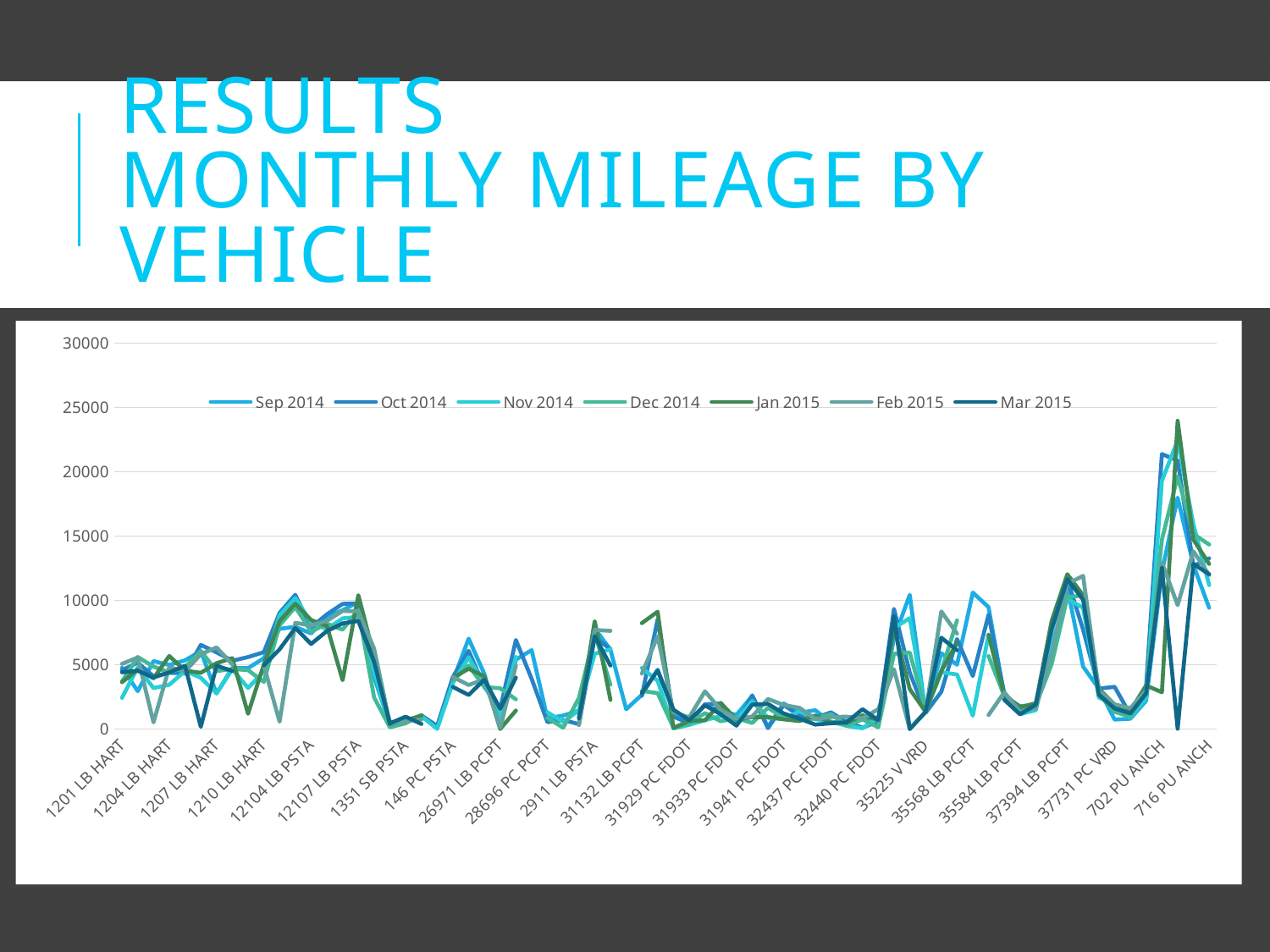
Is the highest value for 37394 LB PCPT greater or less than 10000? greater Are the values for 1201 LB HART greater or less than 10000? less Which vehicle label on the x axis has the highest plotted mileage? 702 PU ANCH Which vehicle has higher mileage values, 12104 LB PSTA or 1351 SB PSTA? 12104 LB PSTA How many series does the legend list? 7 Are the values for 32437 PC FDOT greater or less than 5000? less Which vehicle has higher mileage values, 702 PU ANCH or 1201 LB HART? 702 PU ANCH What is the title of the slide containing the chart? RESULTS MONTHLY MILEAGE BY VEHICLE Which series reaches the highest value on the chart? Jan 2015 What kind of chart is shown on the slide? line chart What is the highest value shown on the vertical axis? 30000